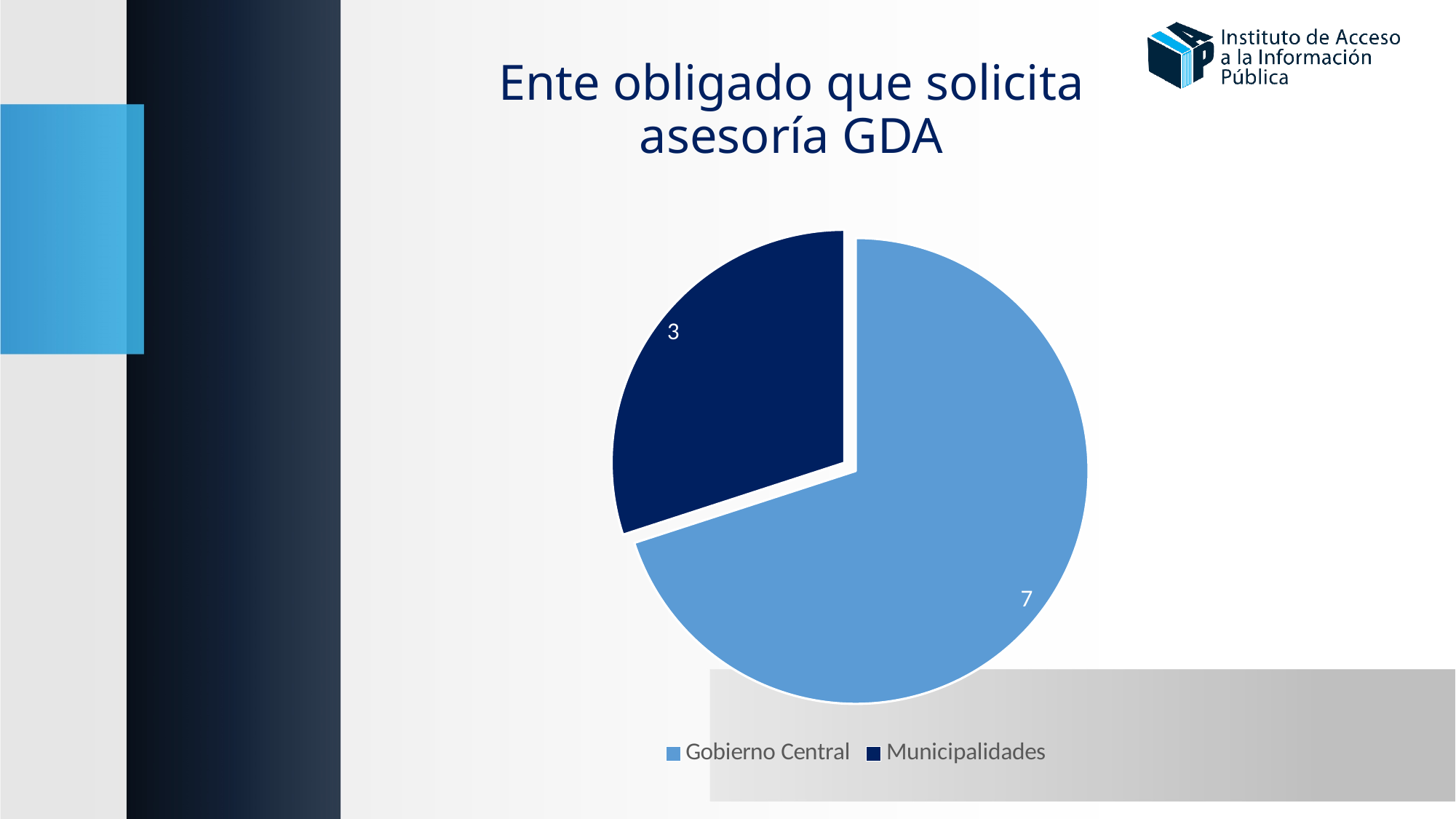
How many categories does the pie chart show? 2 What is the title of the chart? Ente obligado que solicita asesoría GDA Which is larger, the value for Gobierno Central or for Municipalidades? Gobierno Central What type of chart is shown on the slide? pie chart What is the total of all slices in the pie chart? 10 What share of the pie does Gobierno Central represent? 70% Which category has the largest slice? Gobierno Central How many entries does the legend list? 2 What is the value for Gobierno Central? 7 What is the value for Municipalidades? 3 Which category has the smallest slice? Municipalidades What is the difference between the values for Gobierno Central and Municipalidades? 4